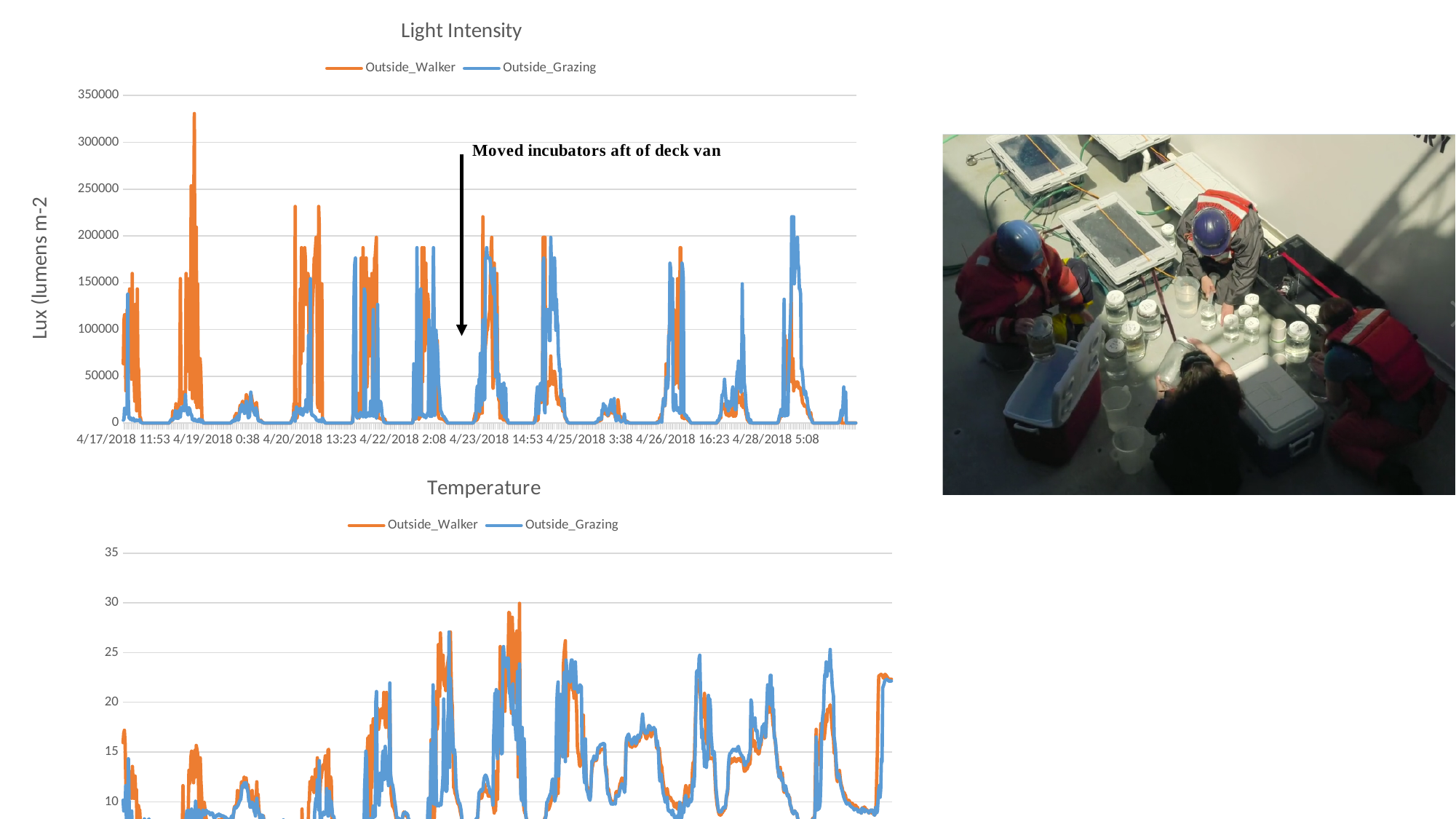
In the Temperature chart, is the highest peak of Outside_Grazing greater or less than 30? less In the Light Intensity chart, is the highest peak of Outside_Grazing greater or less than 250000? less In the Light Intensity chart, which colour represents Outside_Grazing? blue What kind of chart is the Light Intensity chart? line chart How many series does the legend of the Temperature chart list? 2 In the Light Intensity chart, which series reaches the highest peak? Outside_Walker What is the y-axis label of the Light Intensity chart? Lux (lumens m-2 In the Light Intensity chart, is the highest peak of Outside_Walker greater or less than 300000? greater How many series does the legend of the Light Intensity chart list? 2 What does the annotation with the arrow on the Light Intensity chart say? Moved incubators aft of deck van What kind of chart is the Temperature chart? line chart